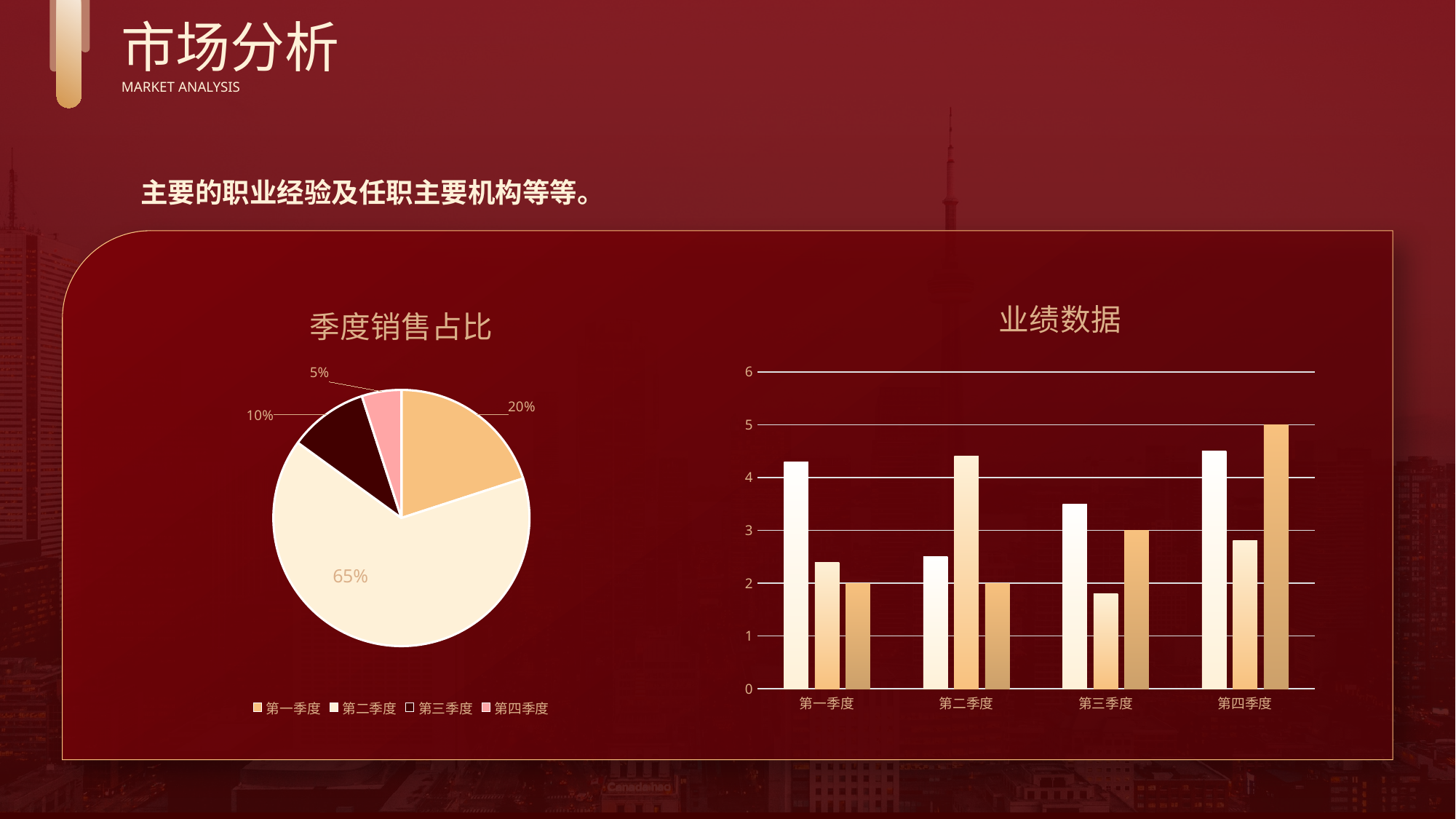
In the pie chart titled 季度销售占比, how many entries does the legend list? 4 In the bar chart titled 业绩数据, how many categories are shown on the x axis? 4 In the pie chart titled 季度销售占比, which quarter has the smallest share? 第四季度 In the pie chart titled 季度销售占比, what share does 第一季度 have? 20% In the pie chart titled 季度销售占比, what share does 第四季度 have? 5% In the pie chart titled 季度销售占比, which quarter has the largest share? 第二季度 In the pie chart titled 季度销售占比, what share does 第二季度 have? 65% In the bar chart titled 业绩数据, is the value of the tallest bar for 第一季度 greater or less than 4? greater What kind of chart is the chart titled 业绩数据? bar chart What is the title of the pie chart on the left of the slide? 季度销售占比 In the pie chart titled 季度销售占比, what is the difference between the shares of 第一季度 and 第三季度? 10% In the bar chart titled 业绩数据, is the value of the shortest bar for 第三季度 greater or less than 2? less